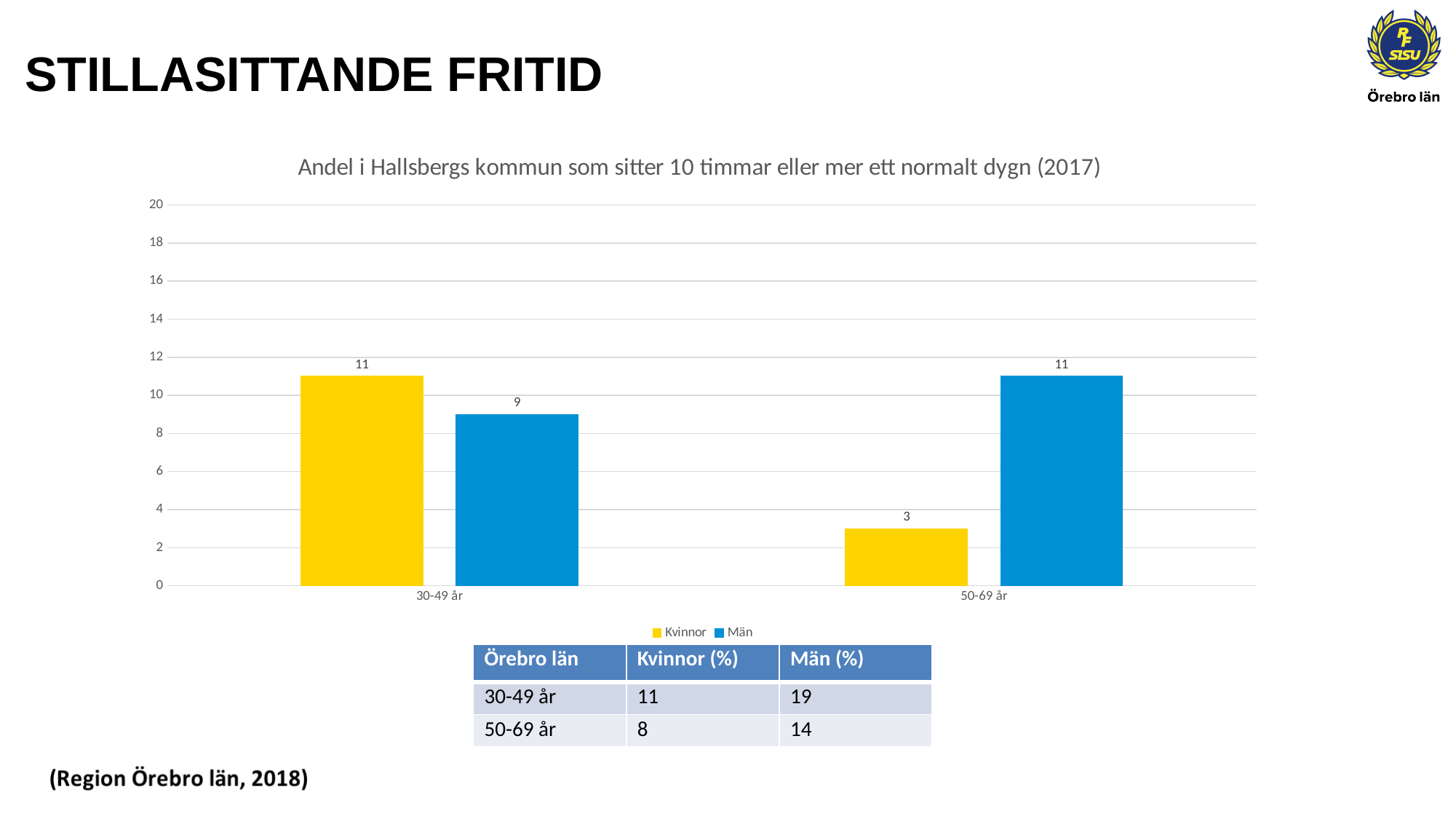
Which age group has the lowest value for Kvinnor? 50-69 år What is the value for Kvinnor in the 50-69 år group? 3 How many series does the legend list? 2 What is the value for Män in the 50-69 år group? 11 How many age groups are shown on the x axis? 2 What is the difference between Män and Kvinnor in the 50-69 år group? 8 What is the value for Kvinnor in the 30-49 år group? 11 What is the difference between Kvinnor and Män in the 30-49 år group? 2 Which age group has the highest value for Män? 50-69 år In the 30-49 år group, which is larger, Kvinnor or Män? Kvinnor What kind of chart is shown on the slide? Bar chart What is the value for Män in the 30-49 år group? 9